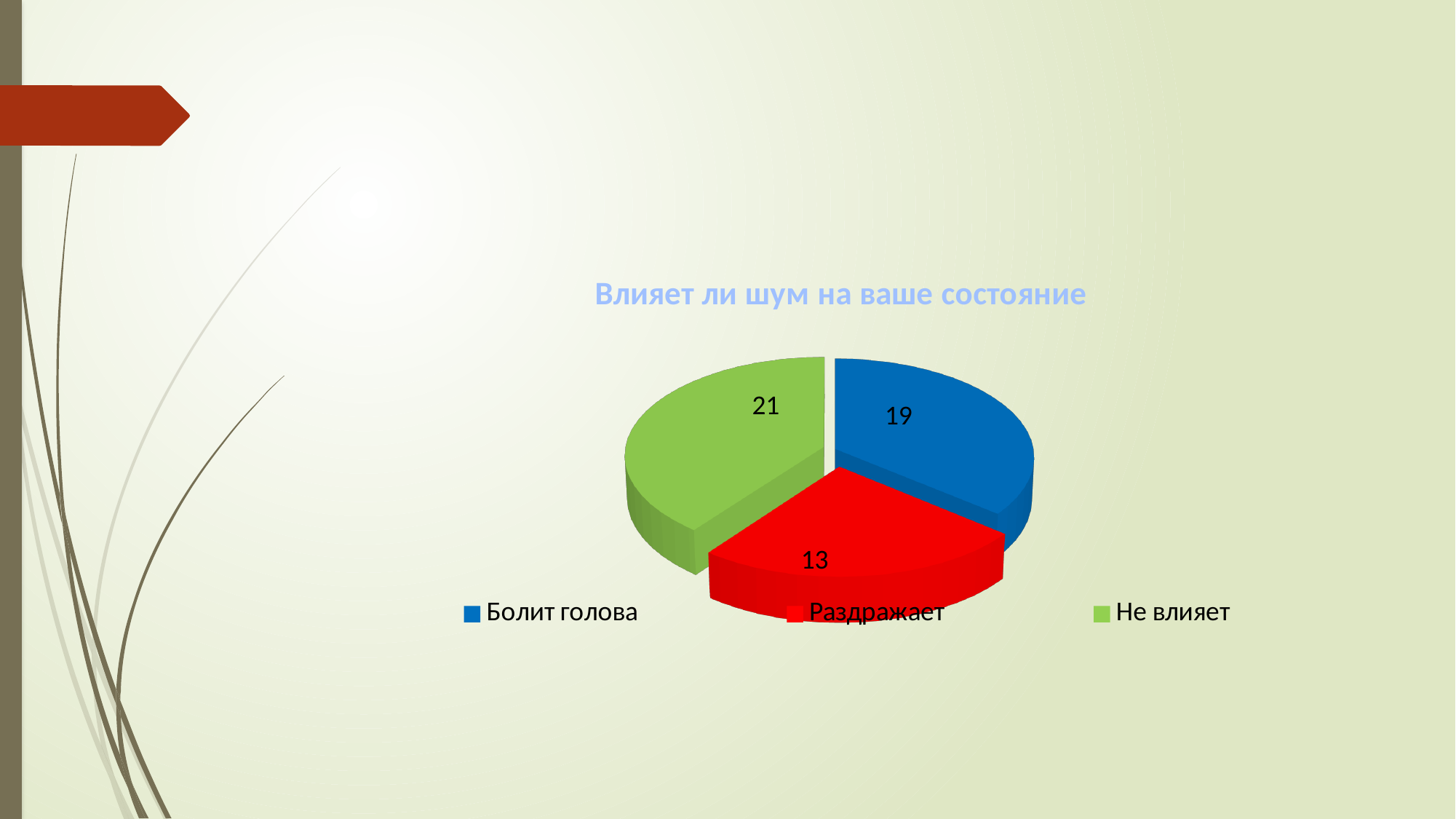
What is the value for Раздражает? 13 What is the difference between the values for Не влияет and Раздражает? 8 Which category has the largest slice? Не влияет What is the value for Болит голова? 19 What is the title of the chart? Влияет ли шум на ваше состояние What type of chart is shown on the slide? pie chart Which is larger, Болит голова or Раздражает? Болит голова What is the difference between the values for Не влияет and Болит голова? 2 Which category has the smallest slice? Раздражает How many categories does the pie chart have? 3 What colour is the slice for Раздражает? red What is the value for Не влияет? 21